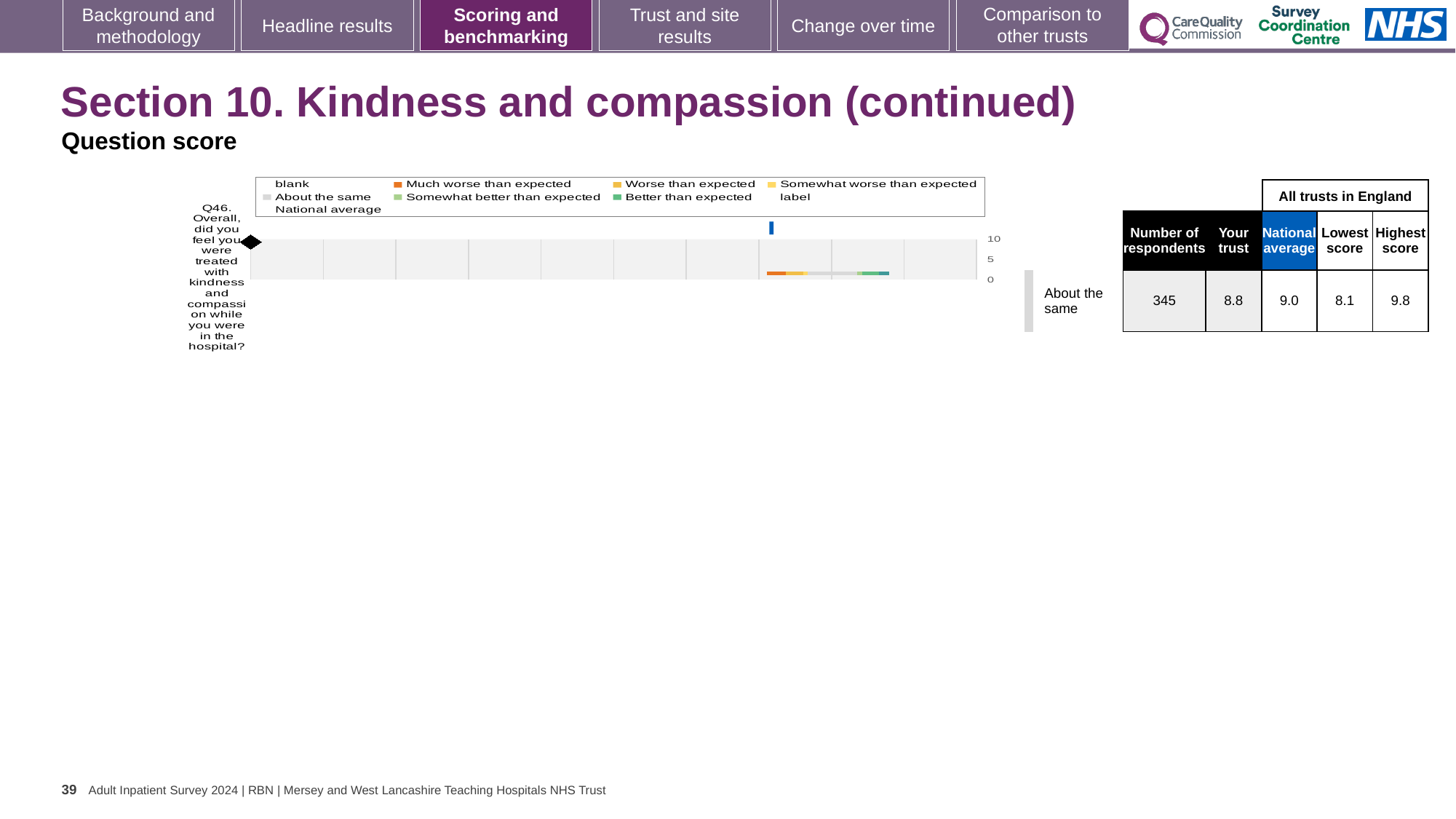
How many entries does the chart legend list? 9 What benchmark category is shown for Q46 next to the chart? About the same How many questions are plotted on the chart? 1 Which is larger for Q46, the 'Your trust' score or the National average? National average What is the Highest score among all trusts in England for Q46? 9.8 What is the 'Your trust' score for Q46 in the table next to the chart? 8.8 How many respondents answered Q46? 345 What is the difference between the Highest score and the Lowest score for Q46? 1.7 What kind of chart is shown on the slide for Q46? bar chart What is the Lowest score among all trusts in England for Q46? 8.1 What is the highest tick value shown on the chart's value axis? 10 What is the National average score for Q46? 9.0